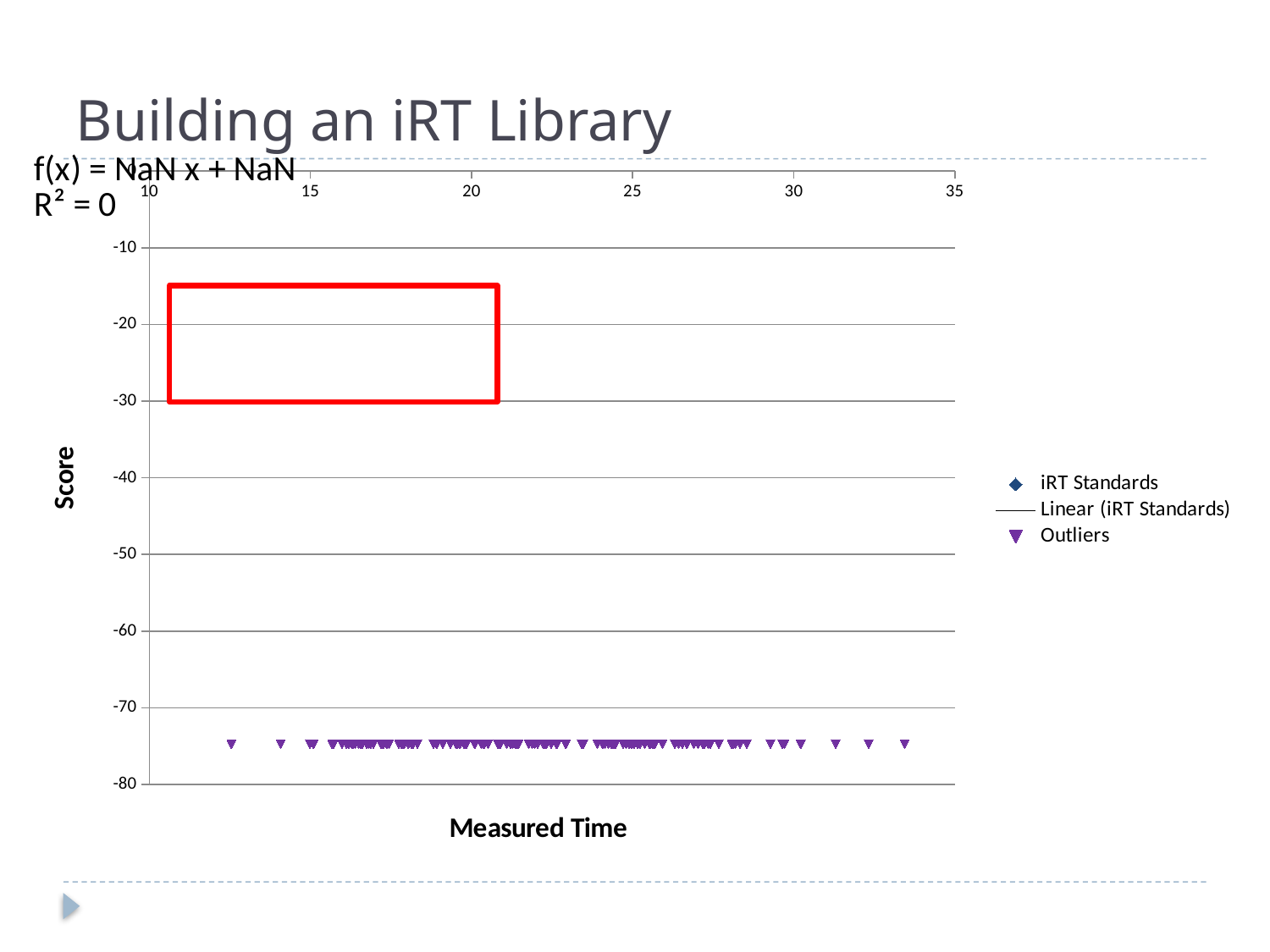
What is the title of the x axis of the chart? Measured Time What kind of chart is shown on the slide? scatter chart What R² value is printed on the chart? 0 Are the plotted Outliers points greater or less than -80 on the Score axis? greater What is the highest value shown on the x axis of the chart? 35 What is the lowest value shown on the Score axis of the chart? -80 Are the plotted Outliers points greater or less than -70 on the Score axis? less Which legend series is drawn with triangle markers? Outliers Do the Outliers values rise, fall, or stay flat as Measured Time increases? stay flat What is the title of the y axis of the chart? Score How many entries does the chart legend list? 3